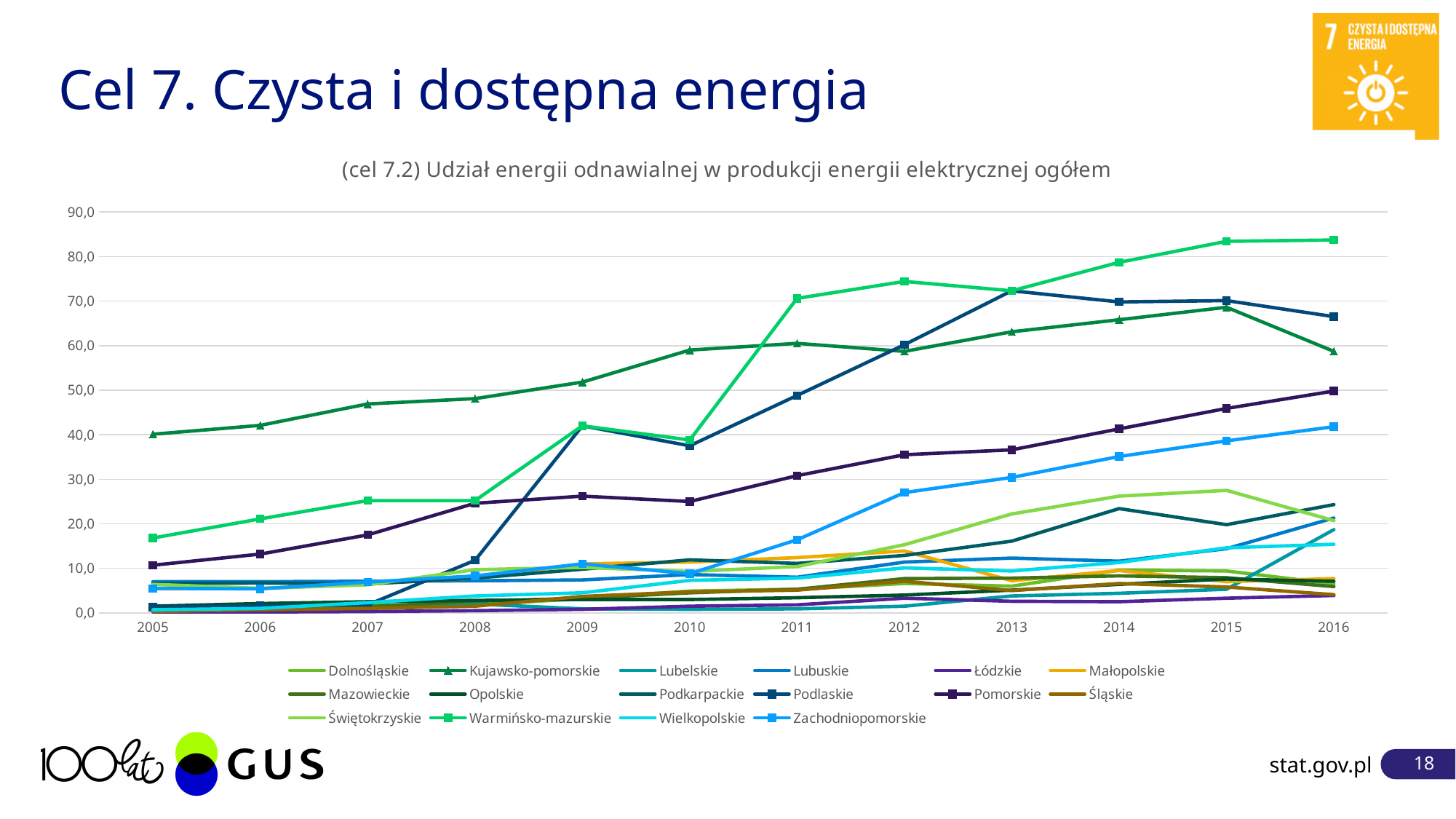
What is the title of the chart? (cel 7.2) Udział energii odnawialnej w produkcji energii elektrycznej ogółem Is the value for Pomorskie in 2016 greater or less than 40? greater In 2016, which is larger: the value for Podlaskie or the value for Pomorskie? Podlaskie Which voivodeship has the highest value in 2016? Warmińsko-mazurskie Is the value for Kujawsko-pomorskie in 2005 greater or less than 50? less Is the value for Zachodniopomorskie in 2016 greater or less than 30? greater Does the value for Warmińsko-mazurskie rise or fall from 2005 to 2016? rise Which voivodeship has the highest value in 2005? Kujawsko-pomorskie How many series does the legend list? 16 What kind of chart is shown on the slide? line chart How many years are shown along the x axis? 12